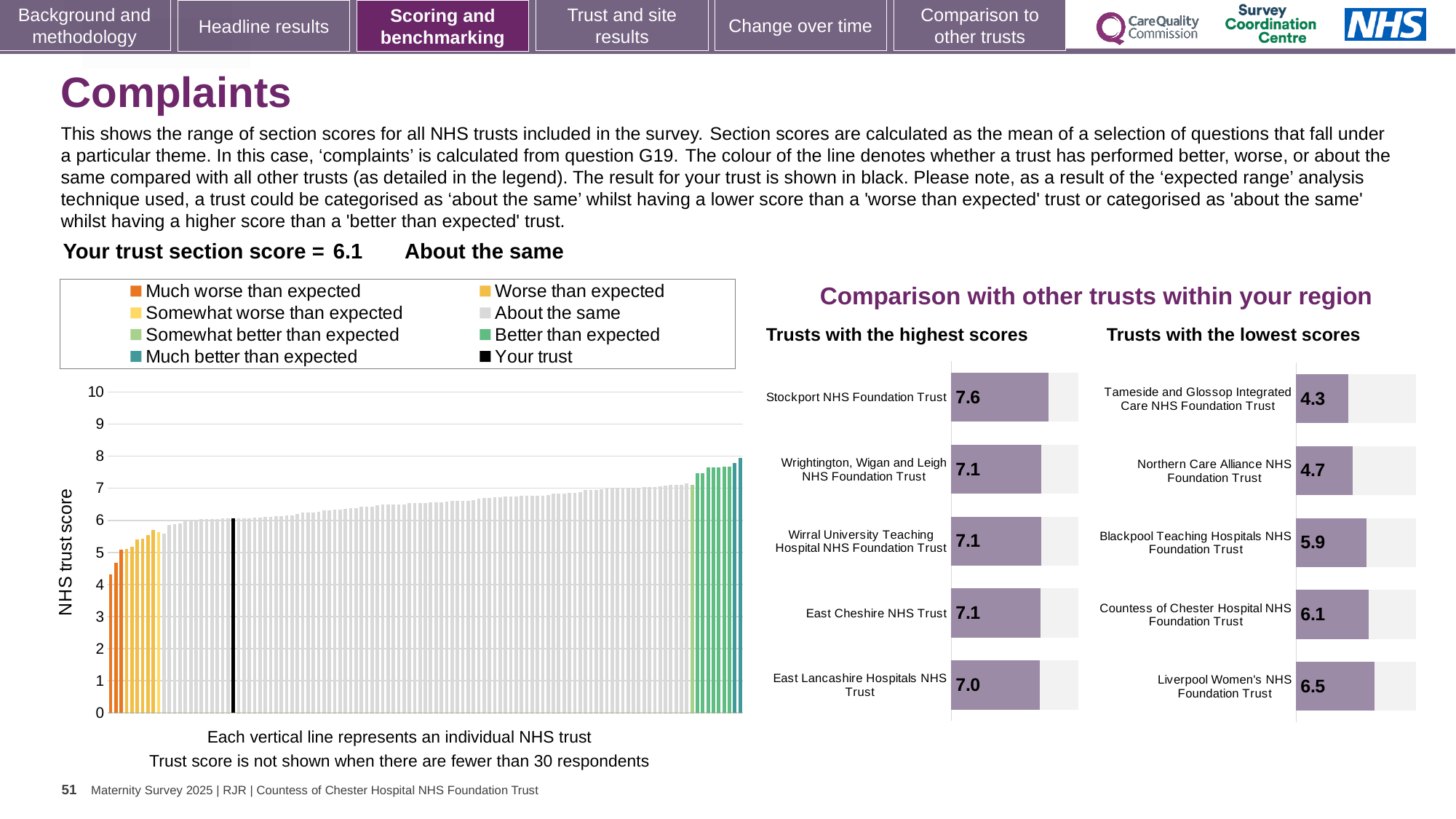
In the 'Trusts with the highest scores' chart, how many trusts are shown? 5 In the NHS trust score chart on the left, is the value of the black 'Your trust' bar greater or less than 5? greater In the 'Trusts with the highest scores' chart, which trust has the lowest score? East Lancashire Hospitals NHS Trust In the 'Trusts with the lowest scores' chart, what is the difference between the scores of Liverpool Women's NHS Foundation Trust and Tameside and Glossop Integrated Care NHS Foundation Trust? 2.2 In the 'Trusts with the lowest scores' chart, what is the score for Tameside and Glossop Integrated Care NHS Foundation Trust? 4.3 In the 'Trusts with the highest scores' chart, what is the difference between the scores of Stockport NHS Foundation Trust and East Lancashire Hospitals NHS Trust? 0.6 In the 'Trusts with the lowest scores' chart, which trust has the highest score? Liverpool Women's NHS Foundation Trust In the NHS trust score chart on the left, do the values rise or fall from left to right? Rise In the 'Trusts with the lowest scores' chart, which has the larger score: Blackpool Teaching Hospitals NHS Foundation Trust or Northern Care Alliance NHS Foundation Trust? Blackpool Teaching Hospitals NHS Foundation Trust In the 'Trusts with the highest scores' chart, what is the score for Stockport NHS Foundation Trust? 7.6 What kind of chart is the NHS trust score chart on the left? Bar chart In the NHS trust score chart on the left, how many entries does the legend list? 8